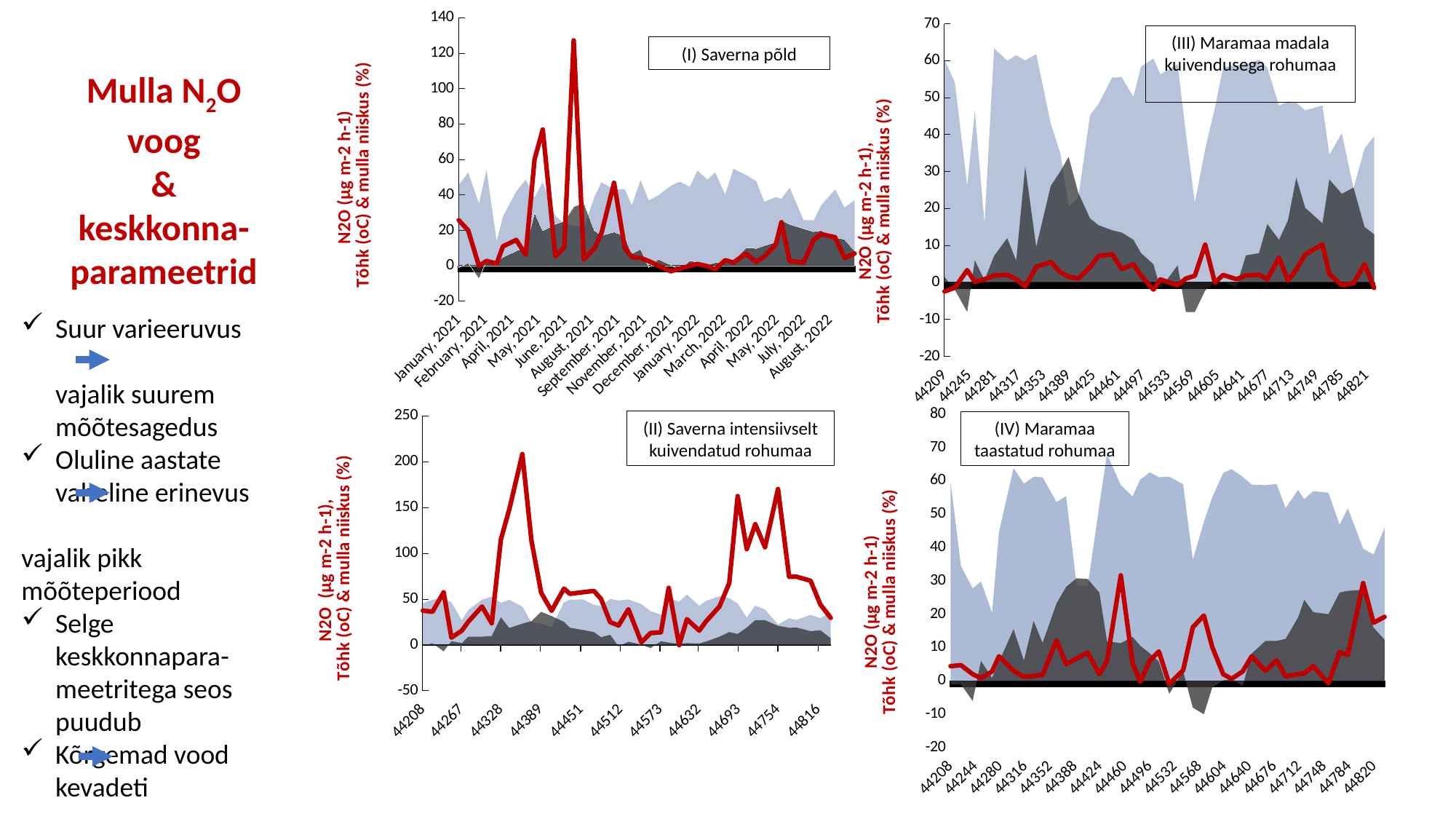
In chart (IV) Maramaa taastatud rohumaa, is the highest value of the red line greater or less than 40? less Which chart has the higher peak of the red line: (I) Saverna põld or (II) Saverna intensiivselt kuivendatud rohumaa? (II) Saverna intensiivselt kuivendatud rohumaa In chart (II) Saverna intensiivselt kuivendatud rohumaa, is the red line's peak near 44754 greater or less than 150? greater What is the title of the bottom-right chart? (IV) Maramaa taastatud rohumaa What is the title of the top-left chart? (I) Saverna põld In chart (II) Saverna intensiivselt kuivendatud rohumaa, is the highest value of the red line greater or less than 200? greater How many charts are shown on the slide? 4 What kind of chart is the top-left chart, (I) Saverna põld? combination area and line chart Which chart has the lower peak of the red line: (III) Maramaa madala kuivendusega rohumaa or (IV) Maramaa taastatud rohumaa? (III) Maramaa madala kuivendusega rohumaa